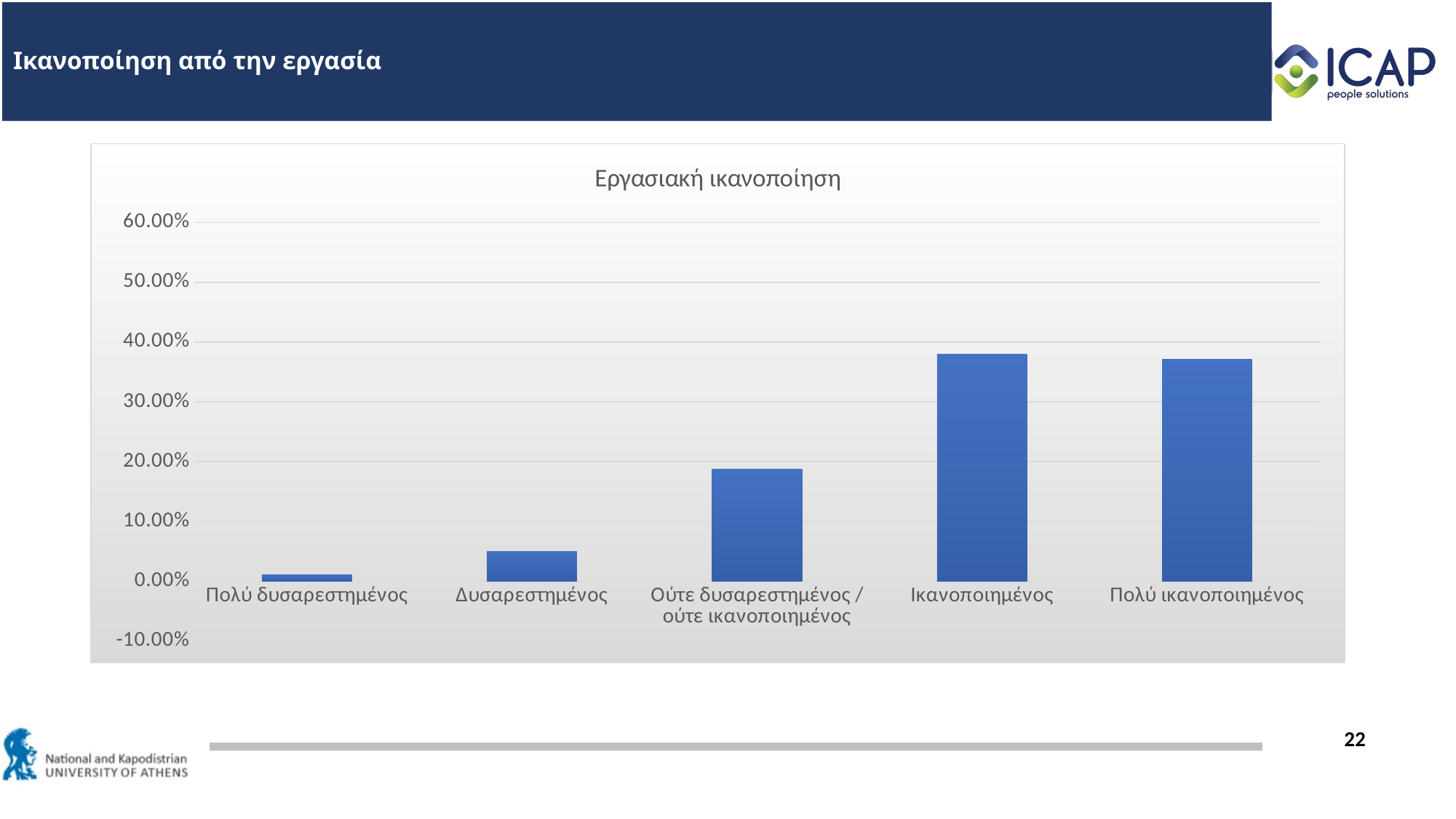
What is the title of the chart? Εργασιακή ικανοποίηση Is the value for Ούτε δυσαρεστημένος / ούτε ικανοποιημένος greater or less than 20.00%? less Which is larger: the value for Ικανοποιημένος or the value for Πολύ δυσαρεστημένος? Ικανοποιημένος Is the value for Δυσαρεστημένος greater or less than 10.00%? less What type of chart is shown on the slide? Bar chart Which is larger: the value for Δυσαρεστημένος or the value for Ούτε δυσαρεστημένος / ούτε ικανοποιημένος? Ούτε δυσαρεστημένος / ούτε ικανοποιημένος Is the value for Πολύ δυσαρεστημένος greater or less than 10.00%? less What colour are the bars in the chart? Blue Which category has the lowest value in the chart? Πολύ δυσαρεστημένος How many categories are shown in the chart? 5